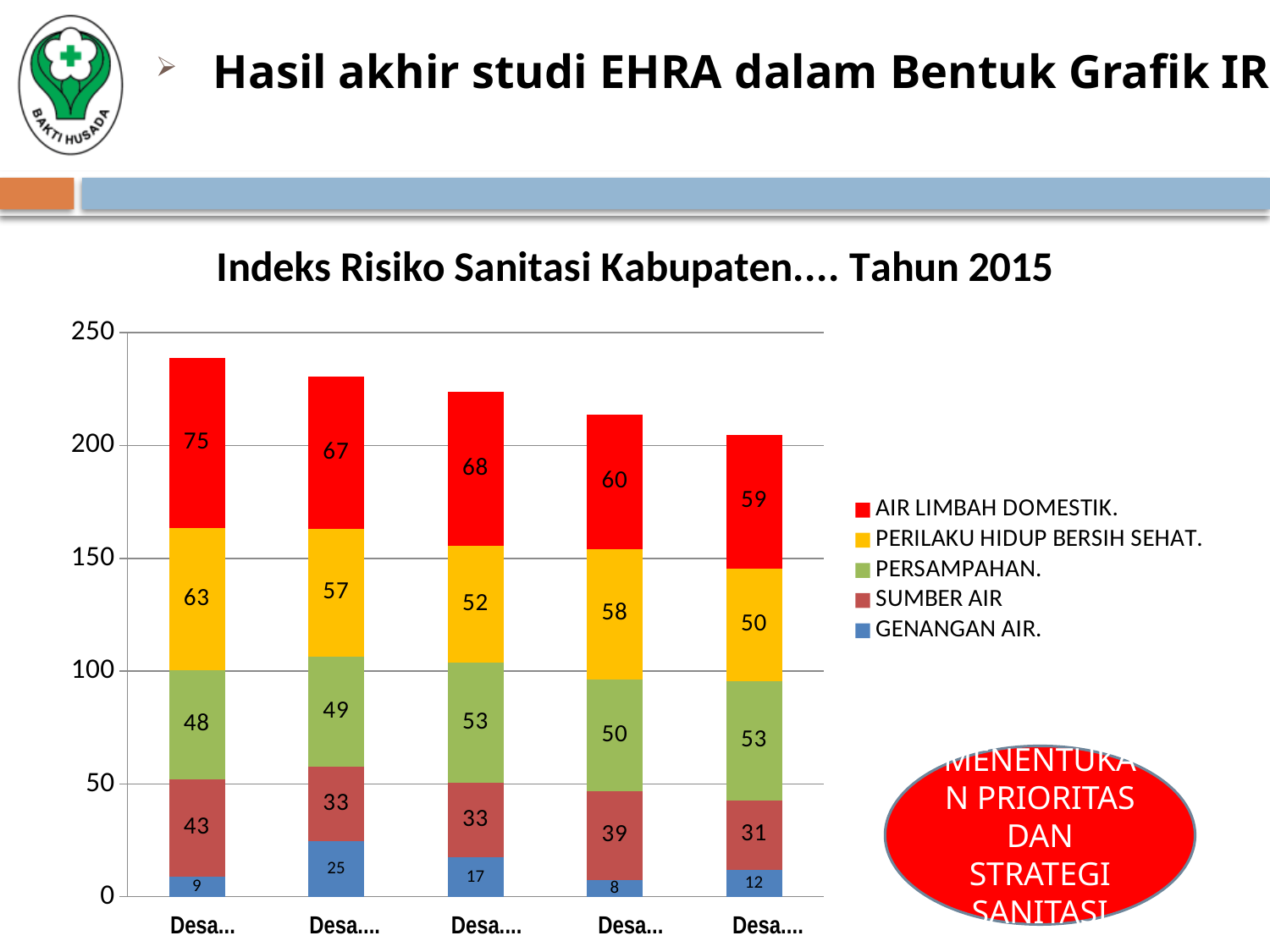
What is the GENANGAN AIR value for the second bar from the left? 25 Which bar has the lowest GENANGAN AIR value? the fourth bar from the left What is the difference between the AIR LIMBAH DOMESTIK values of the leftmost bar and the rightmost bar? 16 What is the SUMBER AIR value for the fourth bar from the left? 39 What kind of chart is shown on the slide? stacked bar chart How many series does the legend list? 5 What is the PERILAKU HIDUP BERSIH SEHAT value for the rightmost bar? 50 What is the total of the stacked leftmost bar? 238 Which bar has the highest AIR LIMBAH DOMESTIK value? the leftmost bar What is the AIR LIMBAH DOMESTIK value for the leftmost bar? 75 Do the total bar heights rise or fall from left to right along the x axis? fall How many bars (categories) are plotted in the chart? 5